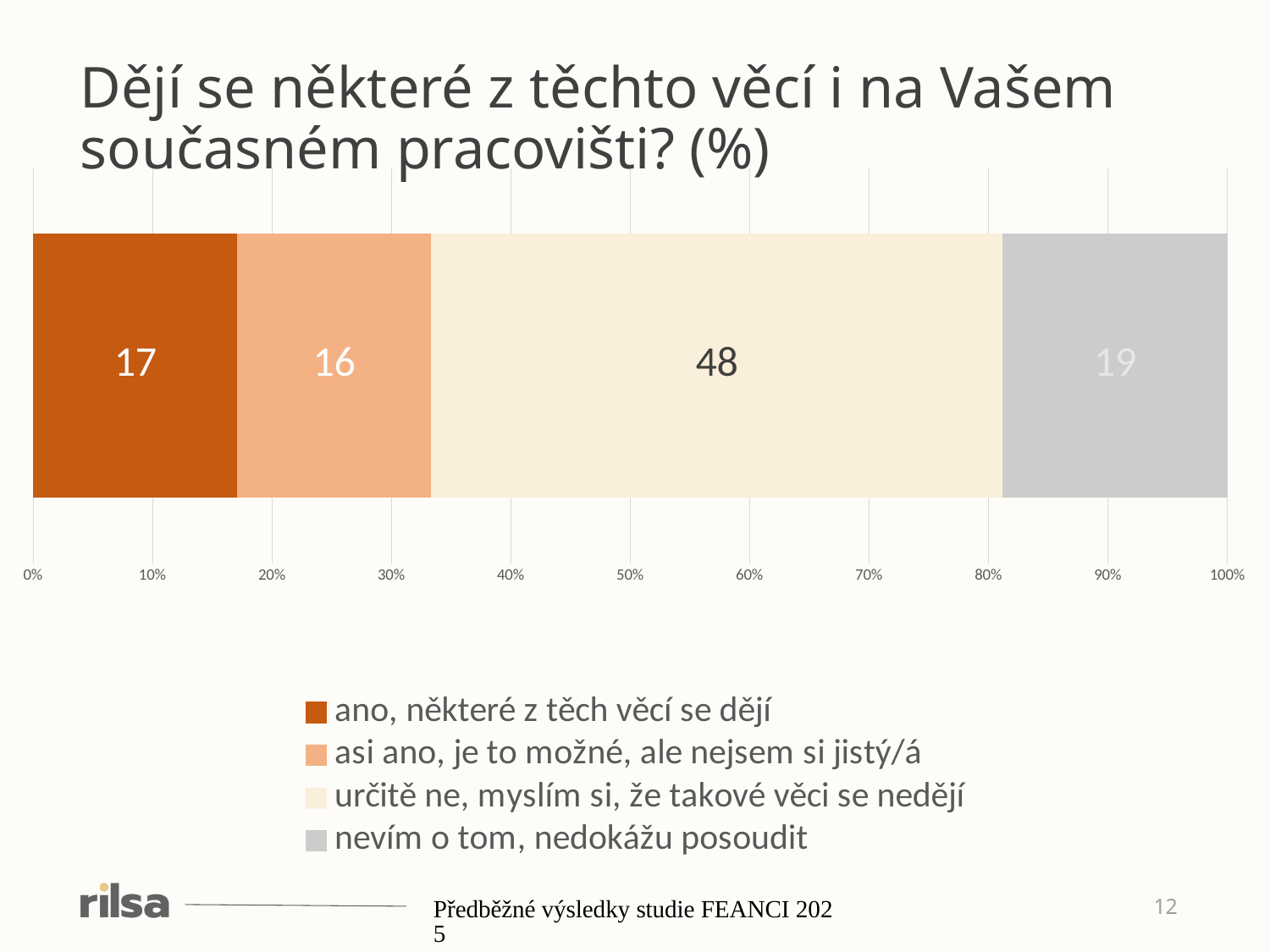
What colour is the segment for "nevím o tom, nedokážu posoudit"? grey Which is larger: the "ano, některé z těch věcí se dějí" segment or the "nevím o tom, nedokážu posoudit" segment? nevím o tom, nedokážu posoudit What value is shown for the segment "asi ano, je to možné, ale nejsem si jistý/á"? 16 What kind of chart is shown on the slide? stacked bar chart Which legend category has the smallest segment in the bar? asi ano, je to možné, ale nejsem si jistý/á What is the difference between the "určitě ne" segment and the "nevím o tom" segment? 29 What value is shown for the segment "nevím o tom, nedokážu posoudit"? 19 Which legend category has the largest segment in the bar? určitě ne, myslím si, že takové věci se nedějí What value is shown for the segment "určitě ne, myslím si, že takové věci se nedějí"? 48 What is the total of all four segments in the stacked bar? 100 How many categories does the legend list? 4 What value is shown for the segment "ano, některé z těch věcí se dějí"? 17